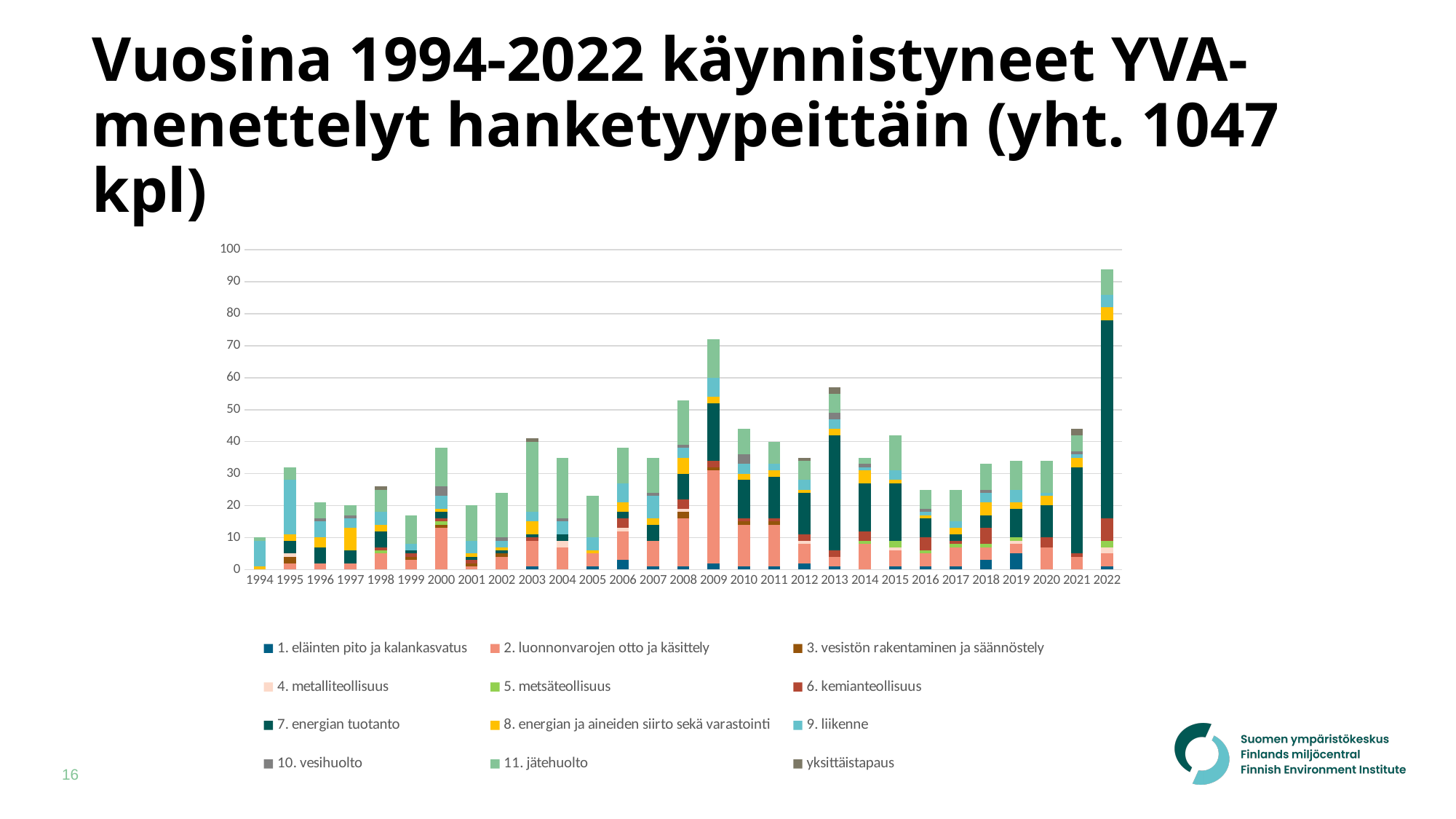
Which year has the taller stacked bar, 2009 or 2013? 2009 Is the total for 2009 greater or less than 60? greater Which legend entry is shown in dark green, the colour that makes up most of the 2022 bar? 7. energian tuotanto How many years are shown along the x axis of the chart? 29 Which year has the shortest stacked bar? 1994 Is the total for 1994 greater or less than 20? less Which year has the taller stacked bar, 1995 or 1996? 1995 Which year has the tallest stacked bar? 2022 How many series does the chart's legend list? 12 Is the total for 2013 greater or less than 50? greater What kind of chart is shown on the slide? Stacked bar chart